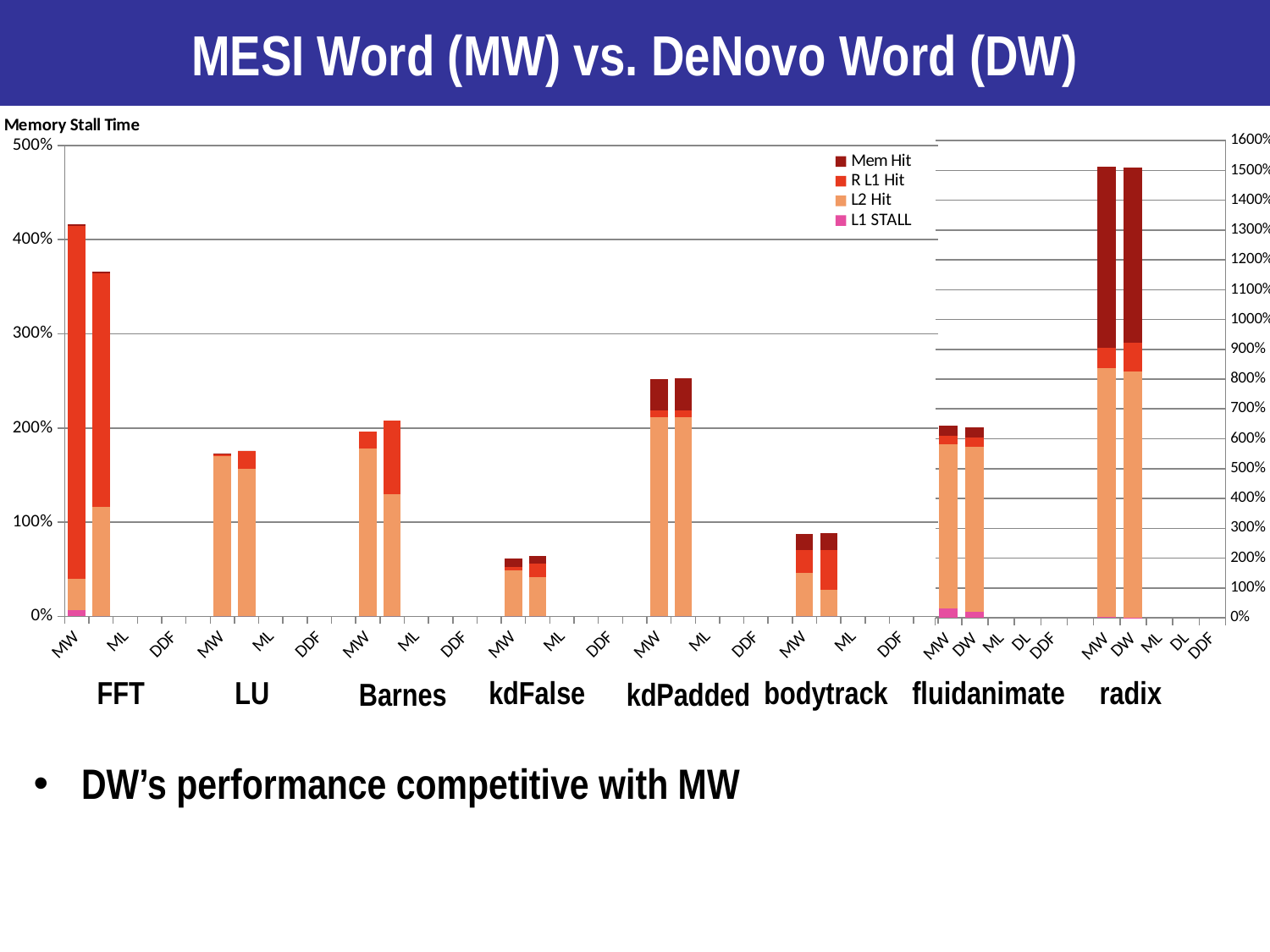
What kind of chart is shown on the slide? Stacked bar chart Is the total for the bodytrack MW bar greater or less than 100%? less What are the legend entries of the Memory Stall Time chart? Mem Hit, R L1 Hit, L2 Hit, L1 STALL How many series does the chart legend list? 4 Among FFT, LU, Barnes, kdFalse, kdPadded and bodytrack, which benchmark has the tallest MW bar? FFT Is the total for the kdPadded MW bar greater or less than 200%? greater Is the total for the kdFalse MW bar greater or less than 100%? less How many benchmark groups are shown along the x axis of the chart? 8